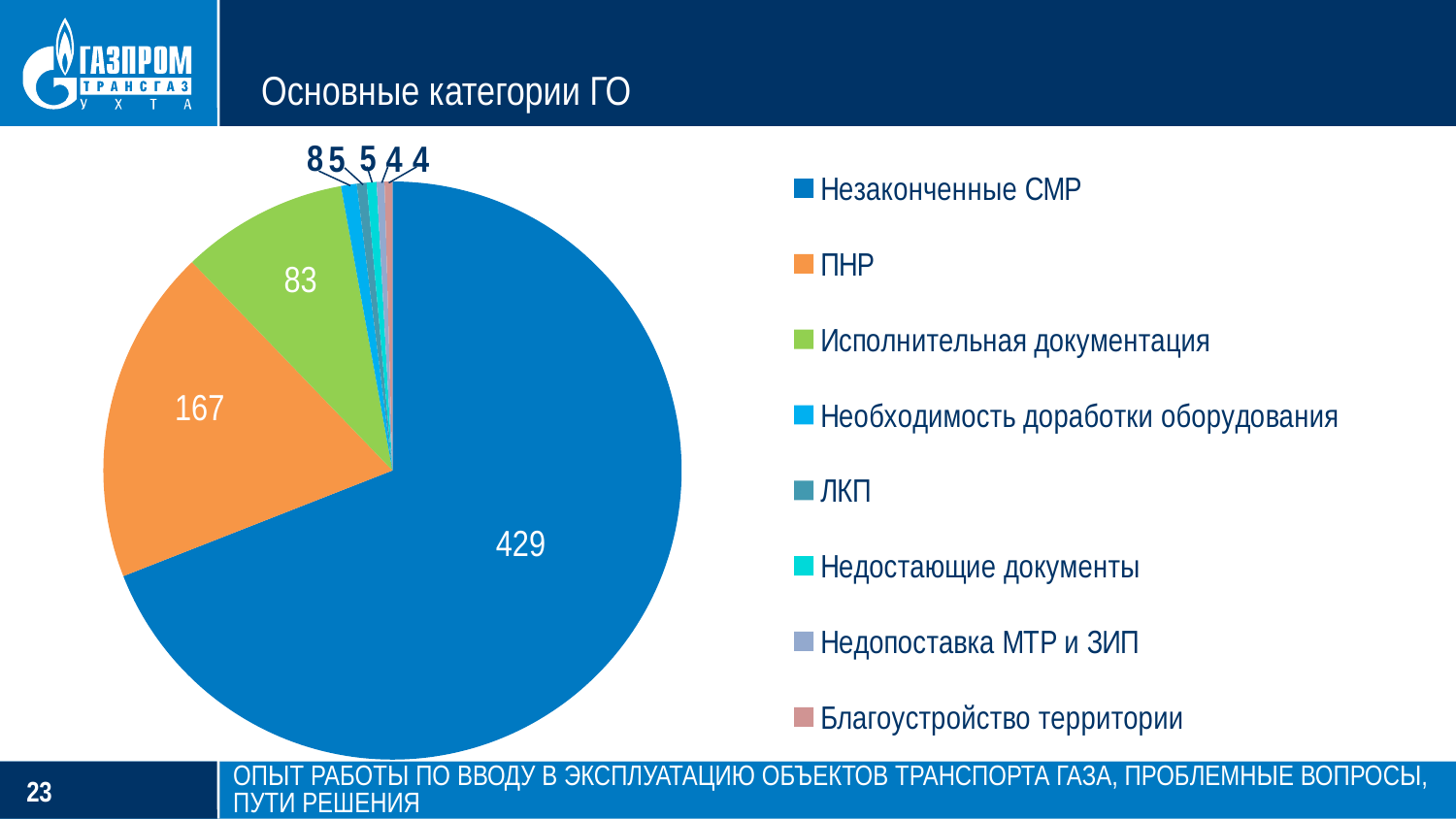
What is the difference between the values for ПНР and Исполнительная документация? 84 What is the value for Исполнительная документация? 83 What colour is the slice for ПНР? orange Which is larger, the value for ПНР or the value for Исполнительная документация? ПНР What is the value for Незаконченные СМР? 429 What kind of chart is shown on the slide? pie chart What is the value for ПНР? 167 Which category is listed last in the legend? Благоустройство территории What is the difference between the values for Незаконченные СМР and ПНР? 262 How many categories does the legend list? 8 Which category has the largest slice of the pie? Незаконченные СМР What is the title of the slide containing the chart? Основные категории ГО